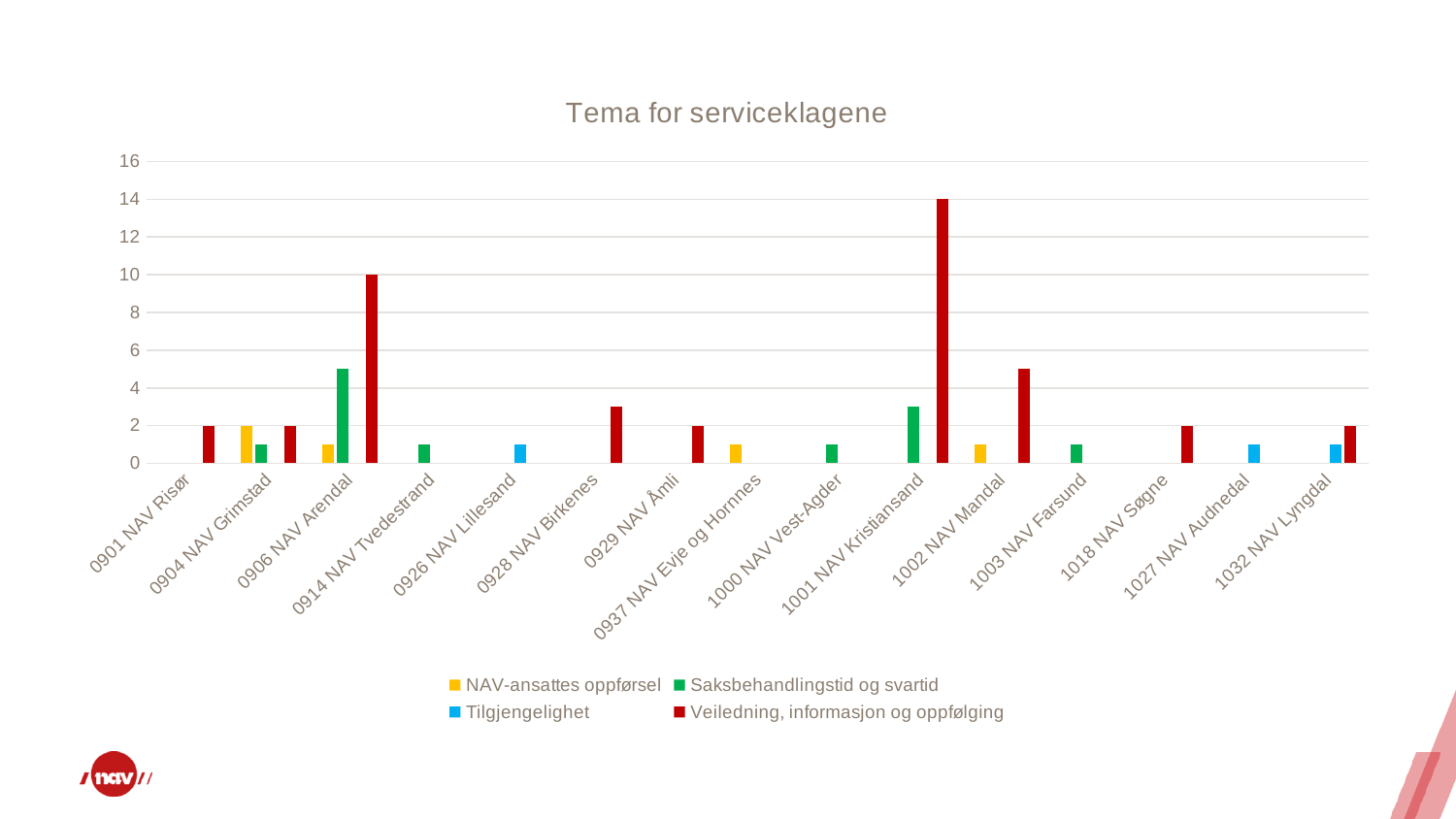
What kind of chart is shown on the slide? bar chart Which is larger: 'Veiledning, informasjon og oppfølging' for 0928 NAV Birkenes or for 0929 NAV Åmli? 0928 NAV Birkenes What is the value of 'NAV-ansattes oppførsel' for 0904 NAV Grimstad? 2 Is the value of 'Veiledning, informasjon og oppfølging' for 1002 NAV Mandal greater or less than 4? greater What is the value of 'Veiledning, informasjon og oppfølging' for 1001 NAV Kristiansand? 14 How many series does the legend list? 4 What is the title of the chart? Tema for serviceklagene Is the value of 'Saksbehandlingstid og svartid' for 0906 NAV Arendal greater or less than 4? greater What is the difference between the 'Veiledning, informasjon og oppfølging' values for 1001 NAV Kristiansand and 0906 NAV Arendal? 4 How many NAV offices (categories) are shown on the x axis? 15 What is the value of 'Veiledning, informasjon og oppfølging' for 0906 NAV Arendal? 10 Which office has the highest value for 'Veiledning, informasjon og oppfølging'? 1001 NAV Kristiansand